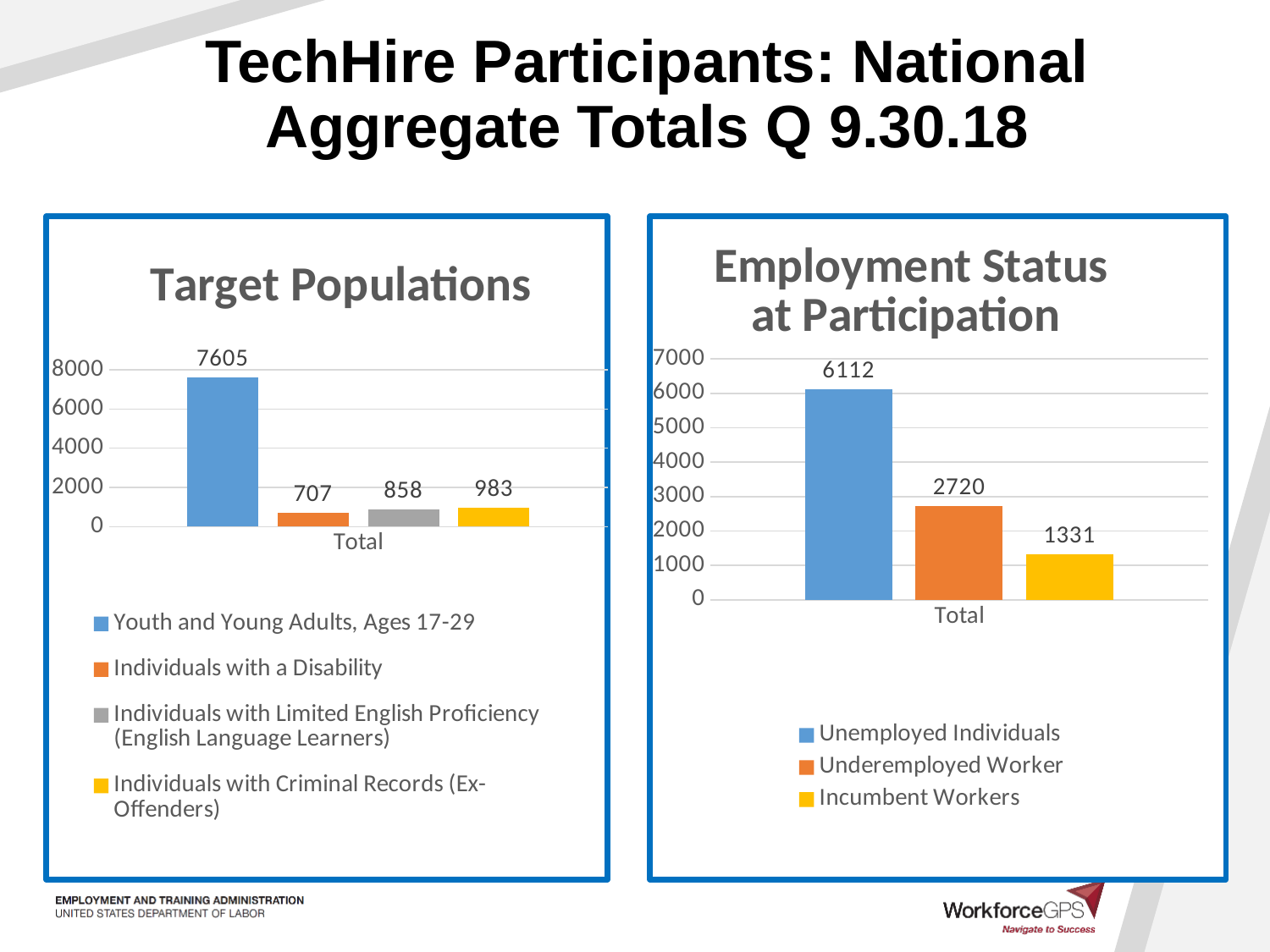
In the Target Populations chart, what is the value for Individuals with a Disability? 707 In the Employment Status at Participation chart, which series has the highest value? Unemployed Individuals In the Employment Status at Participation chart, what is the value for Incumbent Workers? 1331 In the Employment Status at Participation chart, what is the difference between Unemployed Individuals and Underemployed Worker? 3392 In the Employment Status at Participation chart, what is the value for Underemployed Worker? 2720 In the Target Populations chart, what is the value for Youth and Young Adults, Ages 17-29? 7605 What kind of chart is the Employment Status at Participation chart? Bar chart In the Employment Status at Participation chart, what colour is the bar for Incumbent Workers? Yellow In the Employment Status at Participation chart, is the value for Underemployed Worker larger than the value for Incumbent Workers? Yes In the Target Populations chart, how many series does the legend list? 4 In the Target Populations chart, what is the difference between the values for Individuals with Criminal Records (Ex-Offenders) and Individuals with Limited English Proficiency (English Language Learners)? 125 In the Target Populations chart, which series has the lowest value? Individuals with a Disability